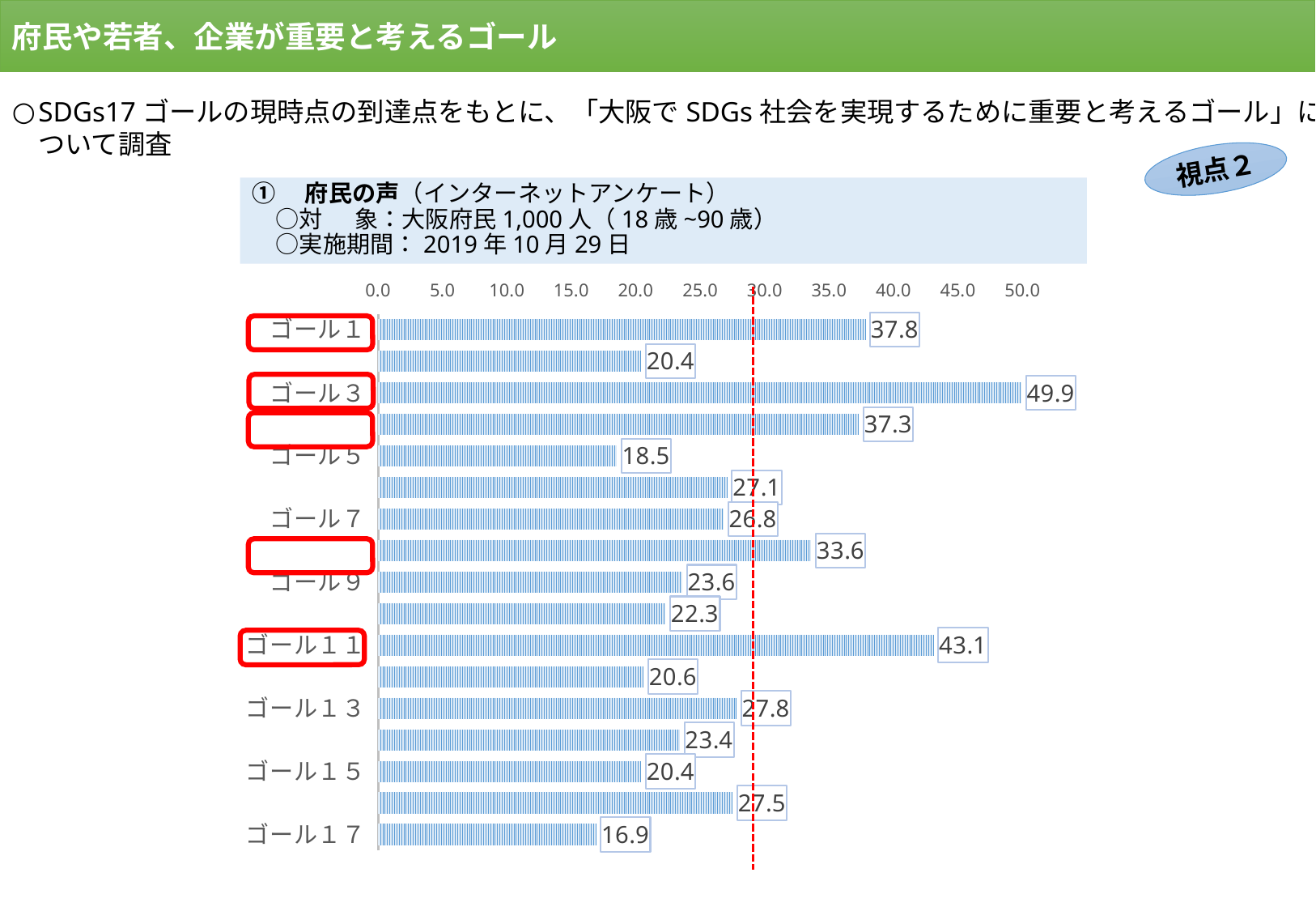
What is the difference between the values for ゴール3 and ゴール1? 12.1 What kind of chart is shown? bar chart What is the value for ゴール11? 43.1 Is the value for ゴール15 greater or less than 25.0? less What is the value for ゴール3? 49.9 Which goal has the highest value? ゴール3 What is the value for ゴール17? 16.9 How many bars are plotted in the chart? 17 Which goal has the lowest value? ゴール17 Which is larger, the value for ゴール13 or the value for ゴール7? ゴール13 What is the value for ゴール1? 37.8 What is the value for ゴール5? 18.5